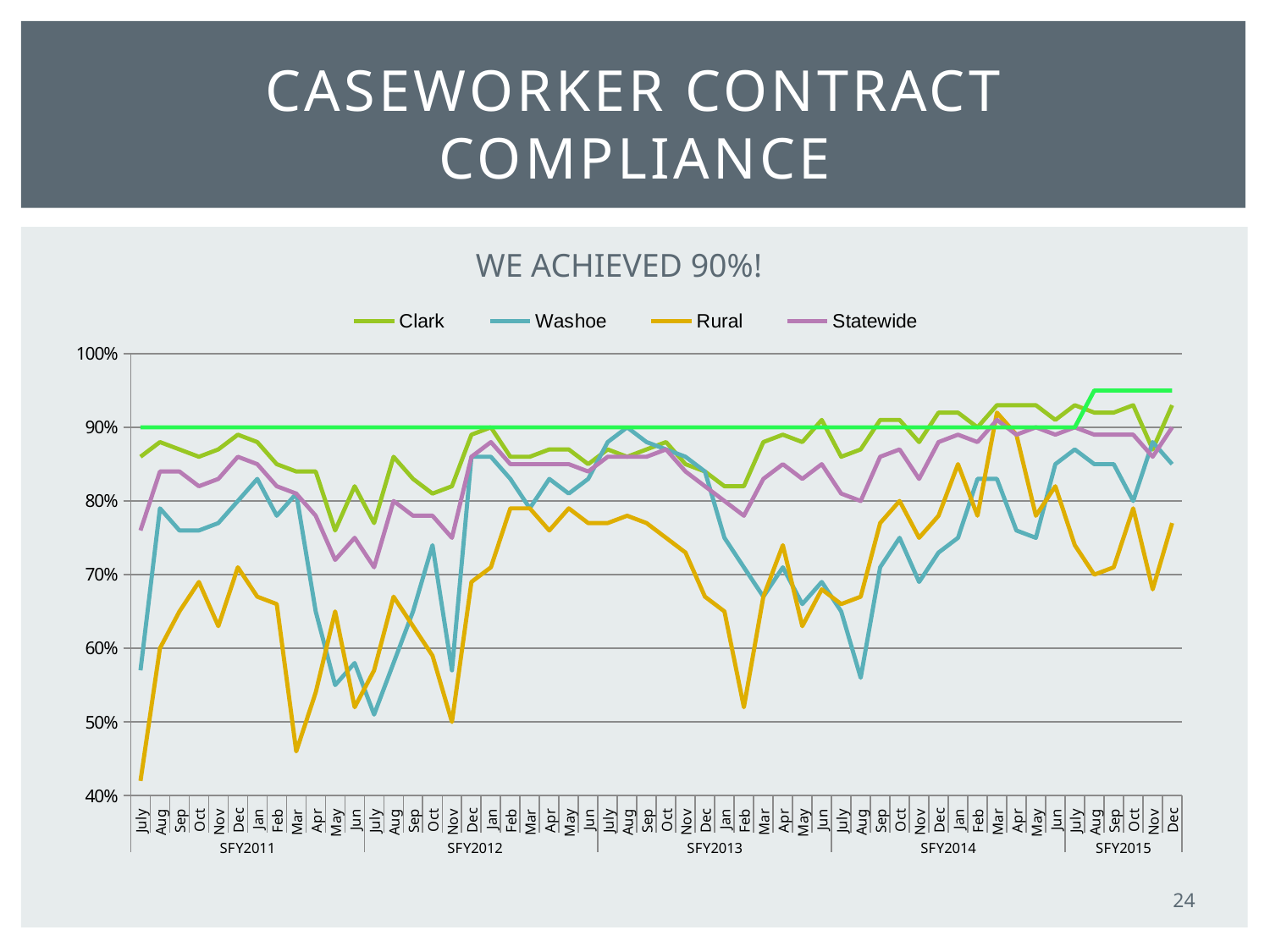
Is the value for Statewide in July SFY2011 greater or less than 70%? greater Is the value for Clark in Dec SFY2015 greater or less than 90%? greater Which series has the lowest value in July SFY2011? Rural Is the value for Washoe in Aug SFY2014 greater or less than 60%? less What kind of chart is shown on the slide? line chart Which series are listed in the chart legend? Clark, Washoe, Rural, Statewide How many state fiscal years (SFY) are labelled along the x axis? 5 What is the subtitle printed above the chart? WE ACHIEVED 90%! In Dec SFY2015, which is higher, Washoe or Rural? Washoe How many series does the chart legend list? 4 Does the Rural line rise or fall from July SFY2011 to Oct SFY2011? rise